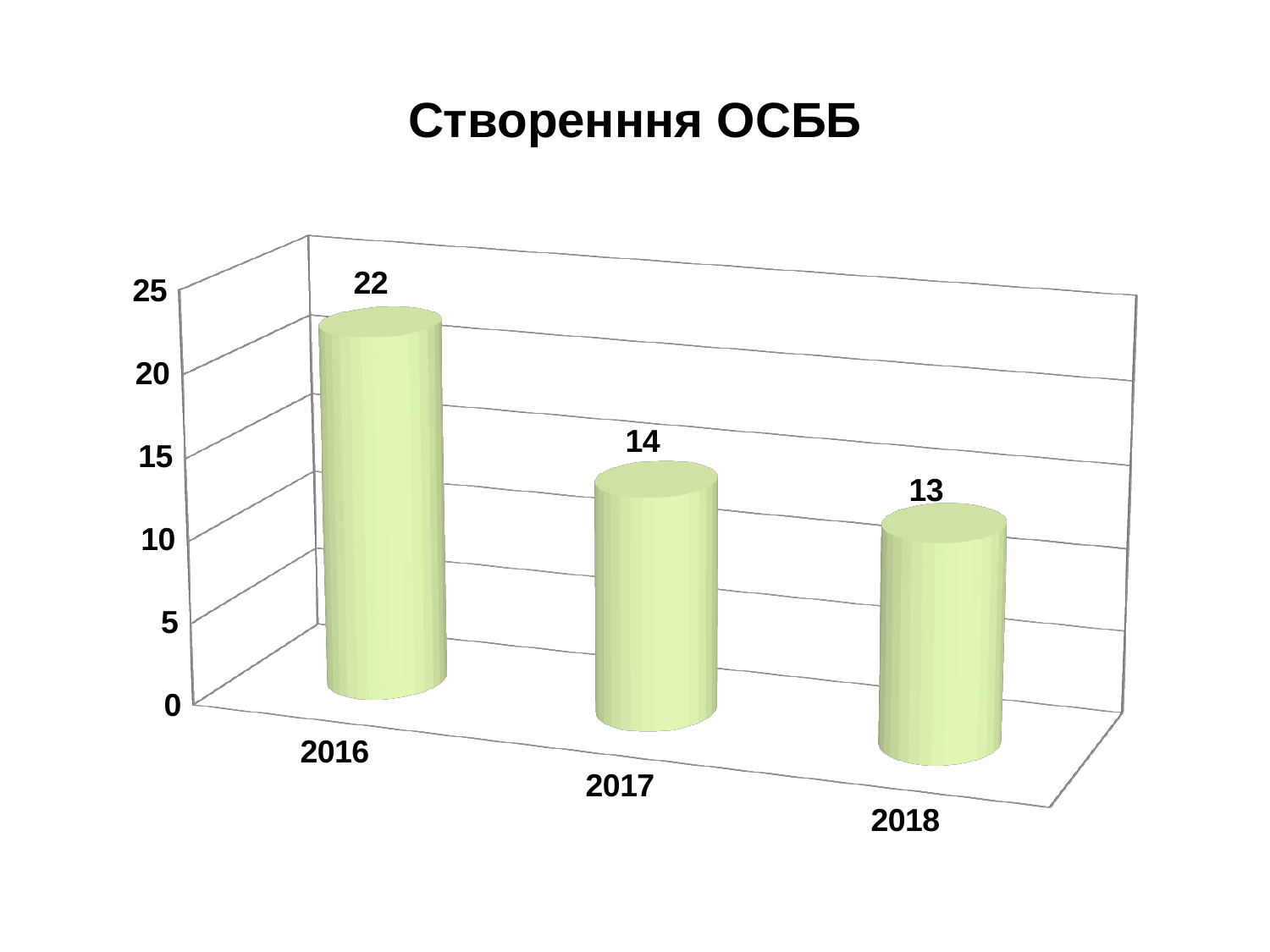
What is the difference between the values for 2017 and 2018? 1 Which year has the lowest value? 2018 Is the value for 2016 greater or less than 20? greater Do the values rise or fall from 2016 to 2018? fall How many years are shown on the x axis? 3 What is the value for 2017? 14 Which is larger, the value for 2016 or the value for 2018? 2016 What is the value for 2016? 22 What kind of chart is shown on the slide? bar chart Which year has the highest value? 2016 What is the difference between the values for 2016 and 2017? 8 What is the value for 2018? 13